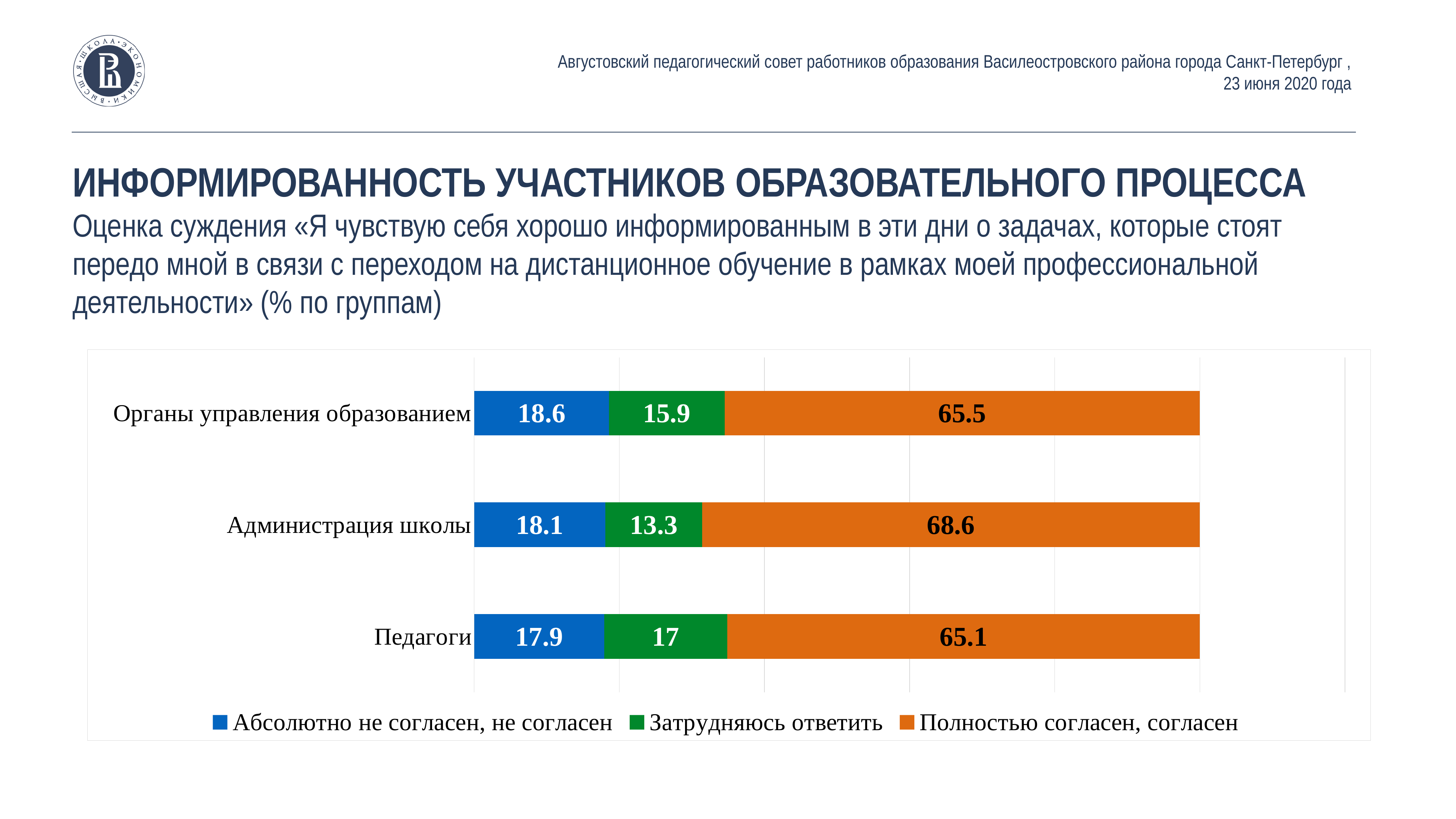
Which group has the highest value for «Полностью согласен, согласен»? Администрация школы How many categories (groups) are shown in the chart? 3 How many series does the legend list? 3 What is the value of «Полностью согласен, согласен» for «Администрация школы»? 68.6 Which is larger: the «Затрудняюсь ответить» value for «Педагоги» or for «Администрация школы»? Педагоги What is the value of «Абсолютно не согласен, не согласен» for «Органы управления образованием»? 18.6 Which colour represents «Полностью согласен, согласен» in the chart? Orange What is the value of «Затрудняюсь ответить» for «Педагоги»? 17 Which group has the lowest value for «Затрудняюсь ответить»? Администрация школы What type of chart is shown on the slide? Stacked bar chart What is the difference between the «Полностью согласен, согласен» values for «Администрация школы» and «Органы управления образованием»? 3.1 What is the total of the stacked bar for «Педагоги»? 100